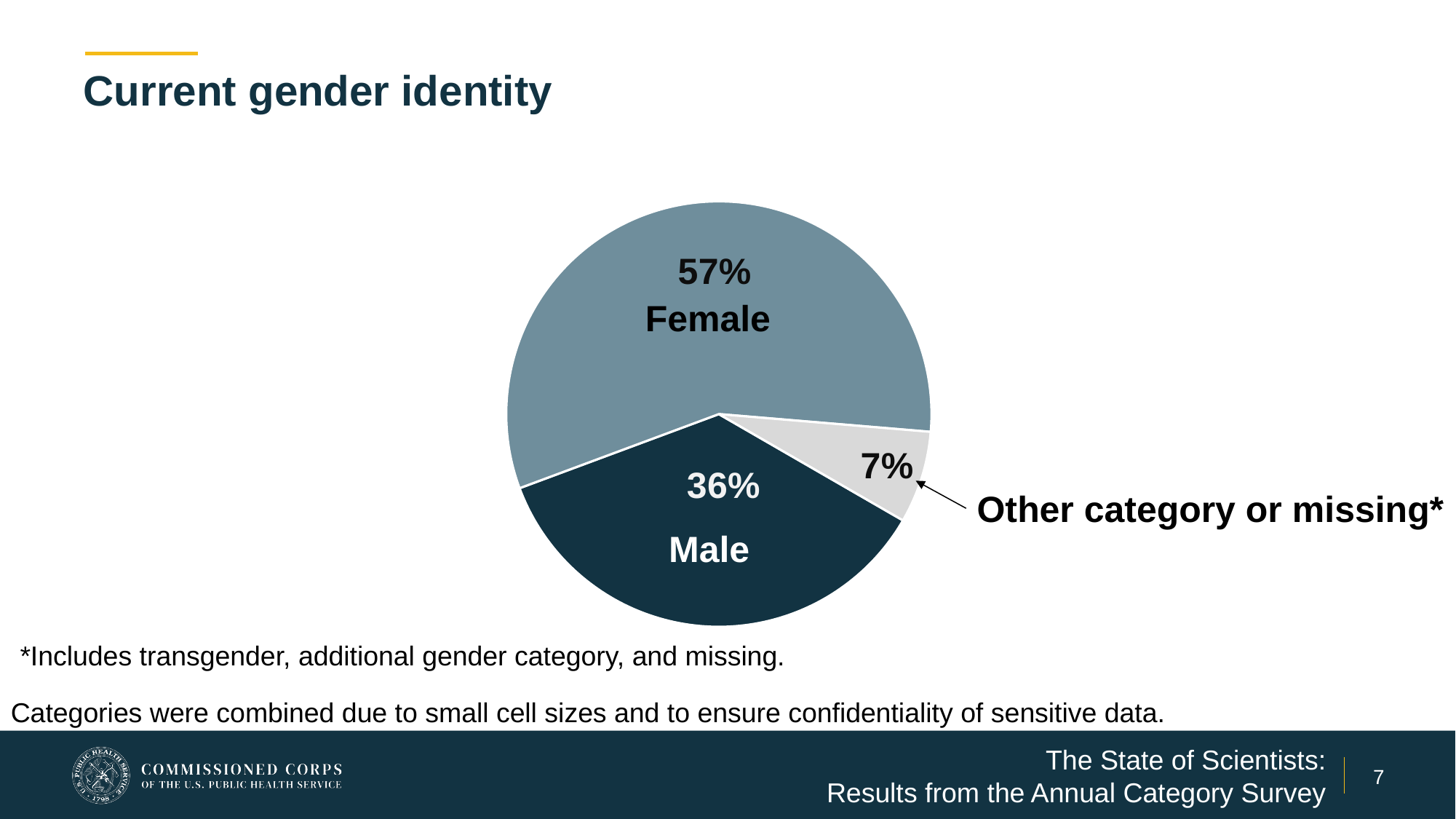
Which category has the smallest share of the pie? Other category or missing* Which slice of the pie is shown in the darkest colour? Male What percentage of respondents identify as Male? 36% What is the title of the slide containing the pie chart? Current gender identity What percentage of respondents identify as Female? 57% Which is larger, the Male slice or the 'Other category or missing*' slice? Male How many slices does the pie chart have? 3 Which category has the largest share of the pie? Female What is the difference in percentage points between the Male slice and the 'Other category or missing*' slice? 29 What kind of chart is shown on the slide? Pie chart What percentage falls into the 'Other category or missing*' slice? 7% What is the difference in percentage points between the Female and Male slices? 21